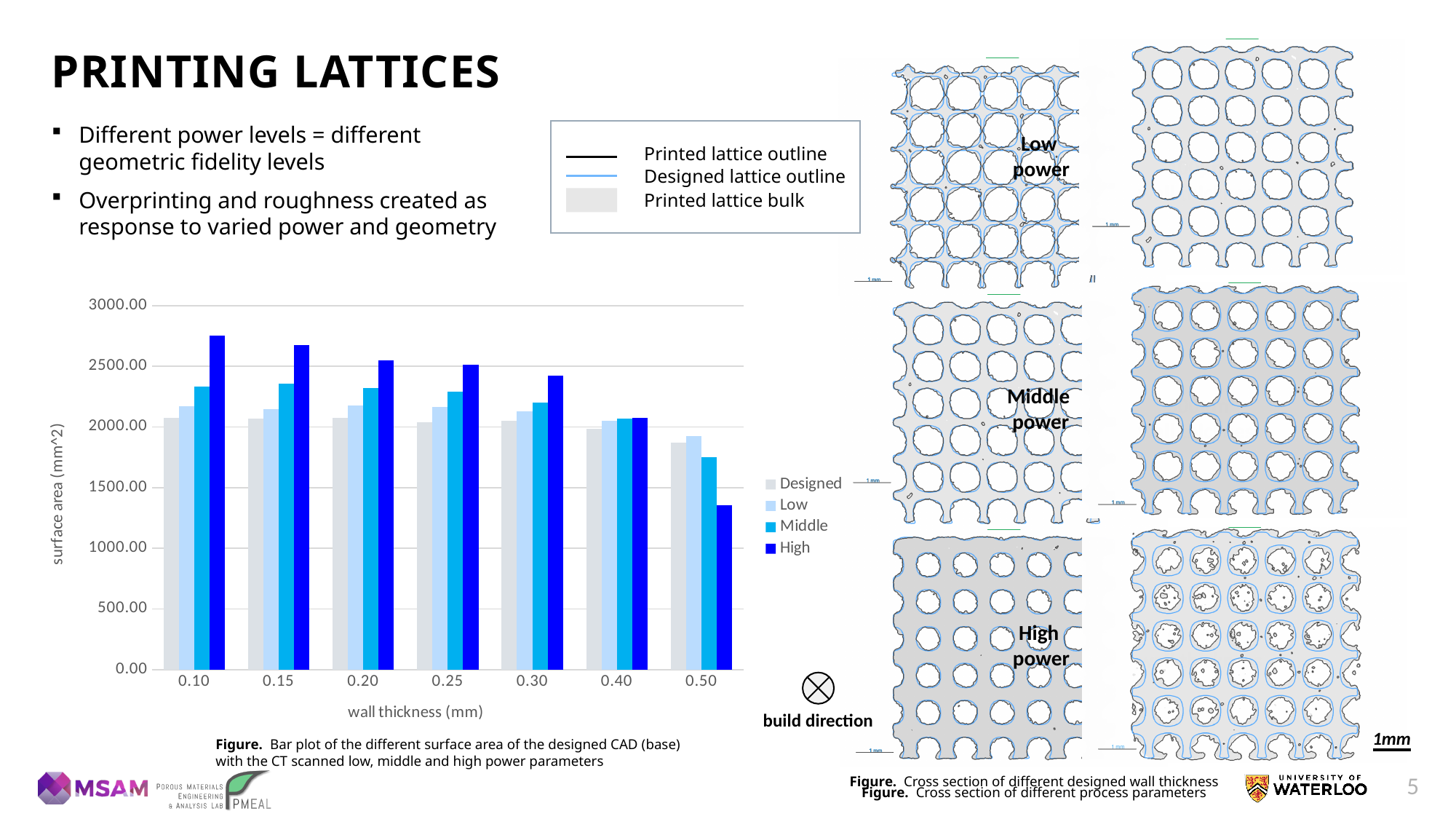
What kind of chart is shown on the left of the slide? bar chart Which series in the bar chart is drawn in the darkest blue? High What is the label of the y axis of the bar chart? surface area (mm^2) Do the High series values rise or fall as wall thickness increases along the x axis? fall Is the Designed series value at wall thickness 0.50 greater or less than 2000? less Is the High series value at wall thickness 0.10 greater or less than 2500? greater How many wall thickness categories are shown on the x axis of the bar chart? 7 How many series does the legend of the bar chart list? 4 Is the High series value at wall thickness 0.50 greater or less than 1500? less At which wall thickness is the High series bar the shortest? 0.50 At which wall thickness is the High series bar the tallest? 0.10 At wall thickness 0.10, which is larger: the Designed bar or the High bar? High